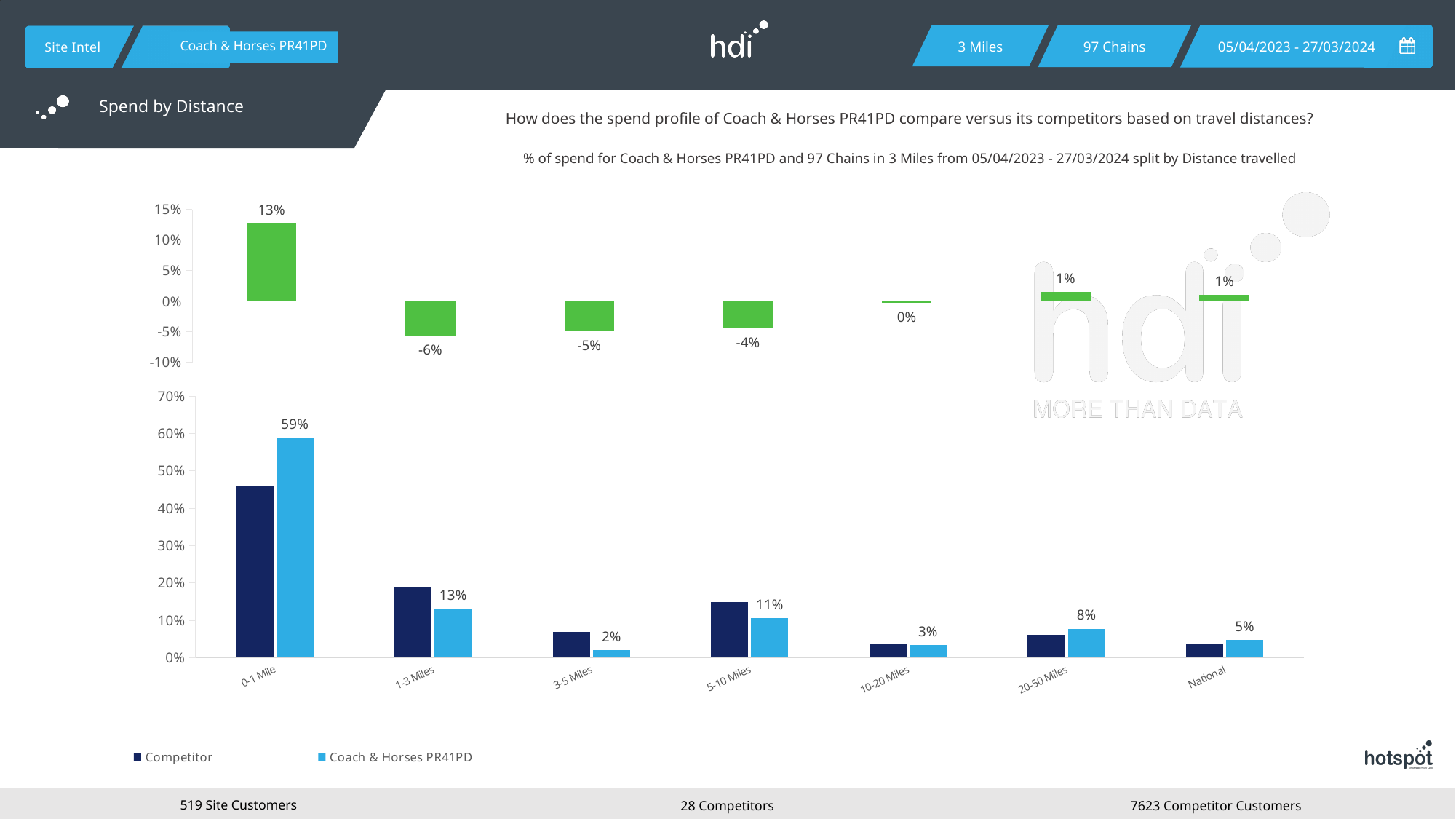
In the bottom chart, which distance band has the lowest value for Coach & Horses PR41PD? 3-5 Miles In the top chart, what is the value for 1-3 Miles? -6% In the bottom chart, what is the value for Coach & Horses PR41PD at 0-1 Mile? 59% In the bottom chart, is the Competitor value at 0-1 Mile greater or less than 40%? greater In the bottom chart, what is the difference between the Coach & Horses PR41PD values at 0-1 Mile and 1-3 Miles? 46% How many distance bands are shown on the x axis of the bottom chart? 7 In the bottom chart, is the Competitor value at 5-10 Miles greater or less than 20%? less How many series does the legend of the bottom chart list? 2 In the bottom chart, what is the value for Coach & Horses PR41PD at 5-10 Miles? 11% In the bottom chart, at 1-3 Miles, which series has the larger value: Competitor or Coach & Horses PR41PD? Competitor In the top chart, which distance band has the highest value? 0-1 Mile What kind of chart is the bottom chart? Bar chart